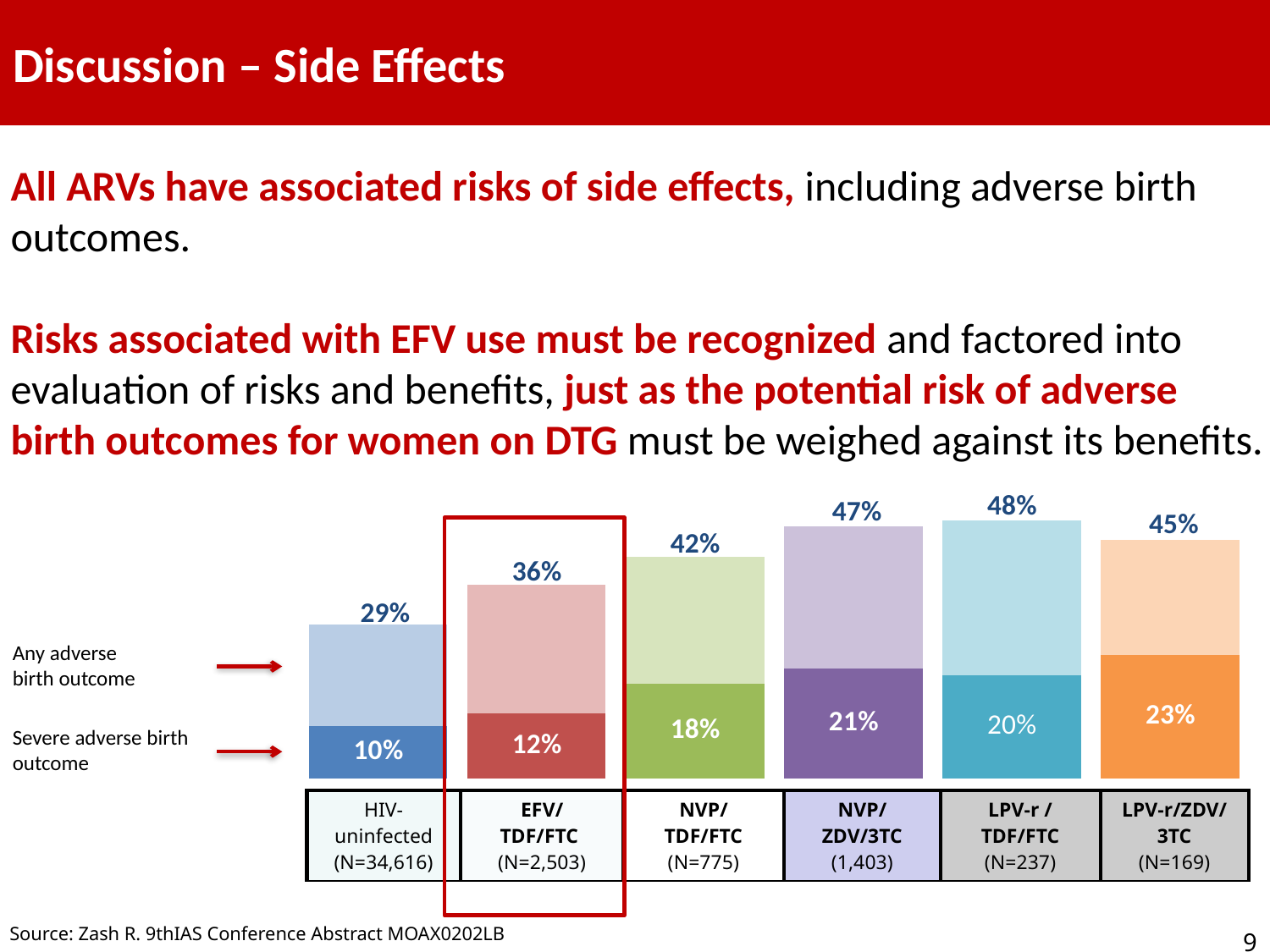
What type of chart is shown on the slide? Bar chart Which group has the lowest rate of severe adverse birth outcome? HIV-uninfected What is the rate of any adverse birth outcome for the EFV/TDF/FTC group? 36% What is the rate of severe adverse birth outcome for the LPV-r/ZDV/3TC group? 23% What is the difference in percentage points between the any adverse birth outcome rates of the NVP/TDF/FTC group and the EFV/TDF/FTC group? 6 percentage points Which group on the chart is highlighted with a red outline? EFV/TDF/FTC Which group has the highest rate of any adverse birth outcome? LPV-r / TDF/FTC What is the rate of severe adverse birth outcome for the HIV-uninfected group? 10% Which group has the highest rate of severe adverse birth outcome? LPV-r/ZDV/3TC Which group has a higher rate of severe adverse birth outcome, NVP/ZDV/3TC or NVP/TDF/FTC? NVP/ZDV/3TC What is the difference in percentage points between the any adverse birth outcome rate and the severe adverse birth outcome rate for the HIV-uninfected group? 19 percentage points How many groups are shown on the x axis of the chart? 6